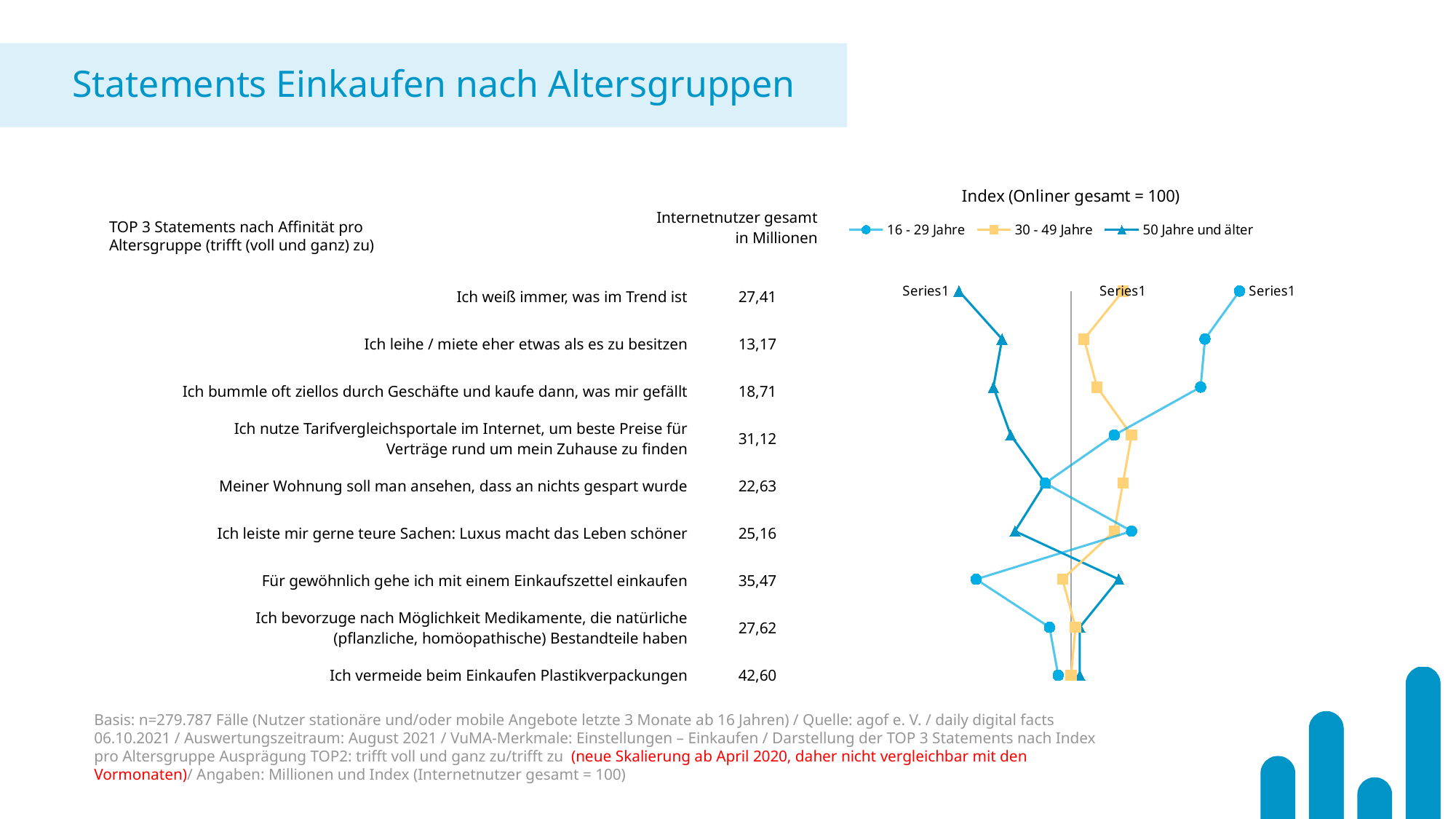
How many statements (categories) are plotted in the chart? 9 What is the value in millions (Internetnutzer gesamt) for 'Ich leihe / miete eher etwas als es zu besitzen'? 13,17 Which statement has the lowest value in millions (Internetnutzer gesamt)? Ich leihe / miete eher etwas als es zu besitzen Which age groups are listed in the chart legend? 16 - 29 Jahre, 30 - 49 Jahre, 50 Jahre und älter What kind of chart is shown on the slide? line chart How many series does the chart legend list? 3 Is the index value for '16 - 29 Jahre' on 'Ich weiß immer, was im Trend ist' greater or less than 100? greater Which statement has the highest value in millions (Internetnutzer gesamt)? Ich vermeide beim Einkaufen Plastikverpackungen Which has the larger value in millions: 'Für gewöhnlich gehe ich mit einem Einkaufszettel einkaufen' or 'Ich nutze Tarifvergleichsportale im Internet, um beste Preise für Verträge rund um mein Zuhause zu finden'? Für gewöhnlich gehe ich mit einem Einkaufszettel einkaufen What is the value in millions (Internetnutzer gesamt) for 'Ich vermeide beim Einkaufen Plastikverpackungen'? 42,60 What is the difference in millions between 'Ich vermeide beim Einkaufen Plastikverpackungen' (42,60) and 'Ich leihe / miete eher etwas als es zu besitzen' (13,17)? 29,43 What is the title shown above the chart legend? Index (Onliner gesamt = 100)